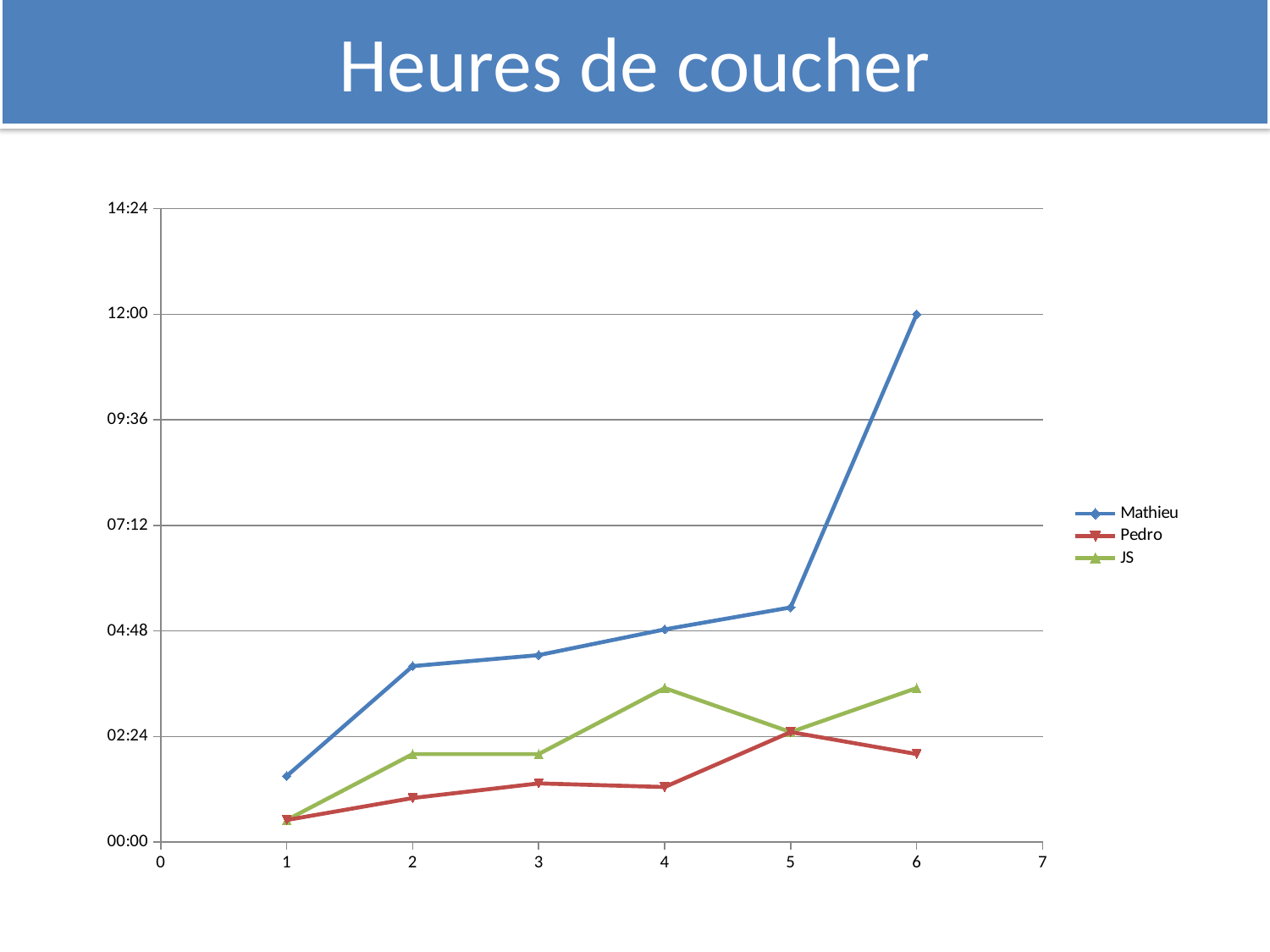
What kind of chart is shown on the slide? line chart How many series does the legend list? 3 Is the value for Pedro at x = 3 greater or less than 02:24? less Which series has the highest value at x = 6? Mathieu What is the value for Mathieu at x = 6? 12:00 How many data points does the Mathieu series have? 6 Is the value for Mathieu at x = 5 greater or less than 04:48? greater Does the Mathieu series rise or fall from x = 1 to x = 6? rises Is the value for Mathieu at x = 2 greater or less than 04:48? less Which series has the lowest value at x = 6? Pedro At x = 4, which is larger: the value for JS or the value for Pedro? JS What is the title of the slide containing the chart? Heures de coucher